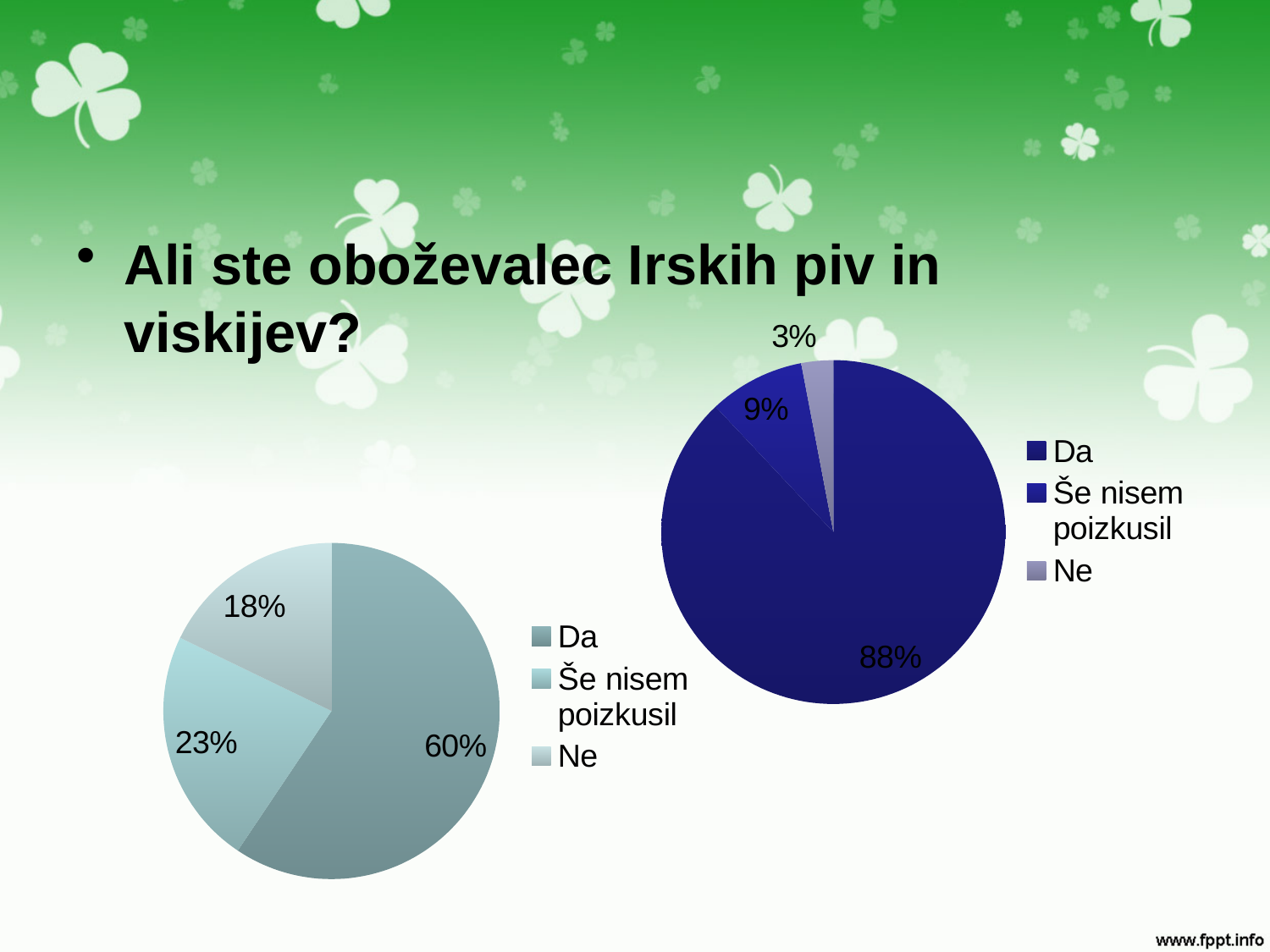
In the pie chart on the left of the slide, what share is labelled for "Ne"? 18% In the pie chart on the left of the slide, which category has the smallest slice? Ne In the pie chart on the left of the slide, what share is labelled for "Da"? 60% What type of chart is the chart on the left of the slide? Pie chart In the pie chart on the right of the slide, what share is labelled for "Da"? 88% How many categories does the legend of the pie chart on the right of the slide list? 3 In the pie chart on the right of the slide, what share is labelled for "Še nisem poizkusil"? 9% In the pie chart on the left of the slide, what is the difference between the shares for "Da" and "Še nisem poizkusil"? 37% Which is larger: the "Da" share in the pie chart on the right or the "Da" share in the pie chart on the left? The pie chart on the right In the pie chart on the right of the slide, what share is labelled for "Ne"? 3% In the pie chart on the left of the slide, what share is labelled for "Še nisem poizkusil"? 23% In the pie chart on the right of the slide, which category has the largest slice? Da